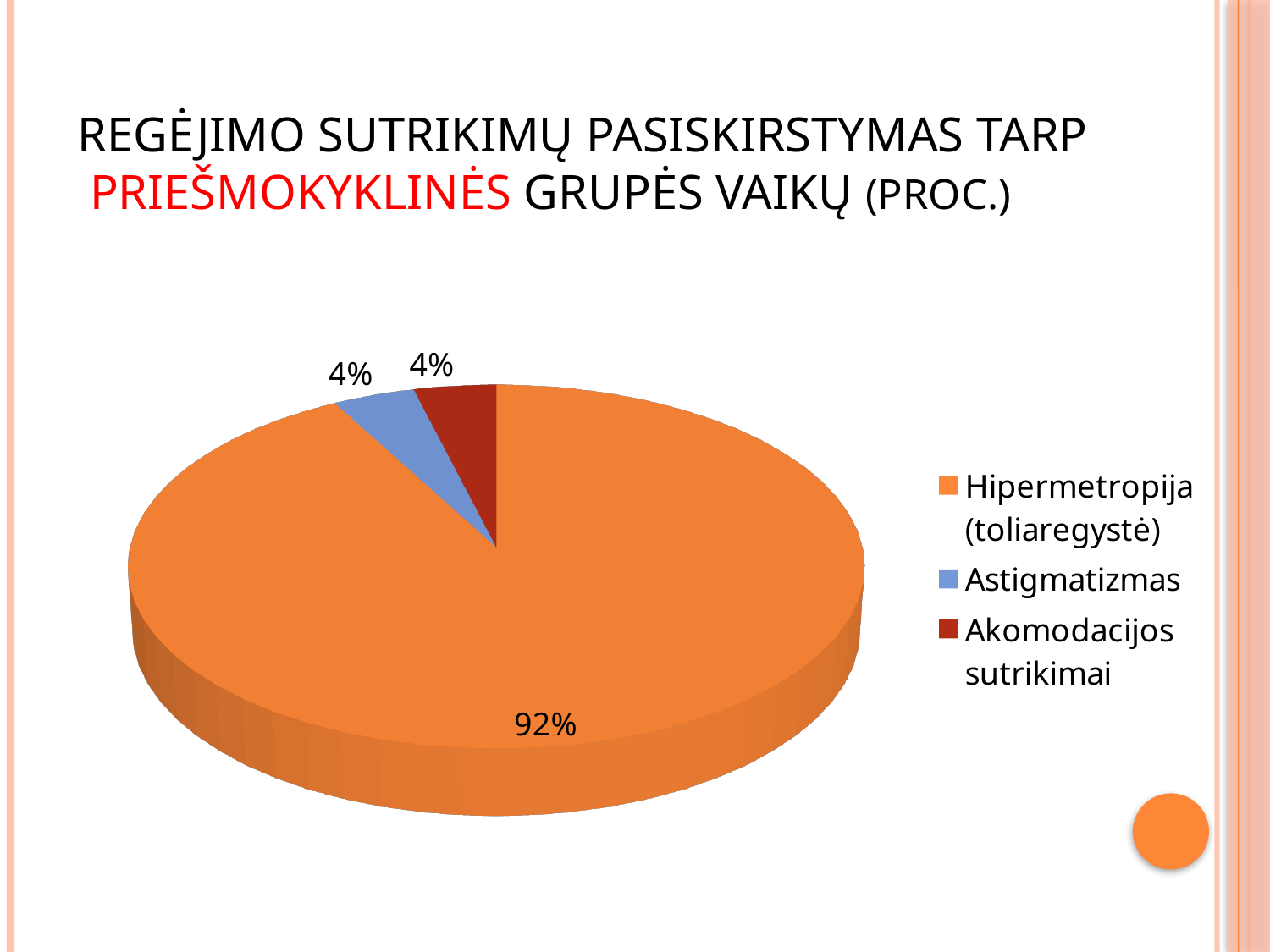
What percentage is shown for Astigmatizmas? 4% What percentage is shown for Akomodacijos sutrikimai? 4% What percentage of the pie does Hipermetropija (toliaregystė) account for? 92% What kind of chart is shown on the slide? Pie chart Which word in the slide title is printed in red? PRIEŠMOKYKLINĖS What is the difference in percentage points between Hipermetropija (toliaregystė) and Astigmatizmas? 88 What colour is the slice for Astigmatizmas? Blue Which is larger, the slice for Hipermetropija (toliaregystė) or the slice for Akomodacijos sutrikimai? Hipermetropija (toliaregystė) How many categories are shown in the pie chart? 3 What share of the pie is taken by Astigmatizmas? 4% How many entries does the legend list? 3 Which category has the largest slice of the pie? Hipermetropija (toliaregystė)